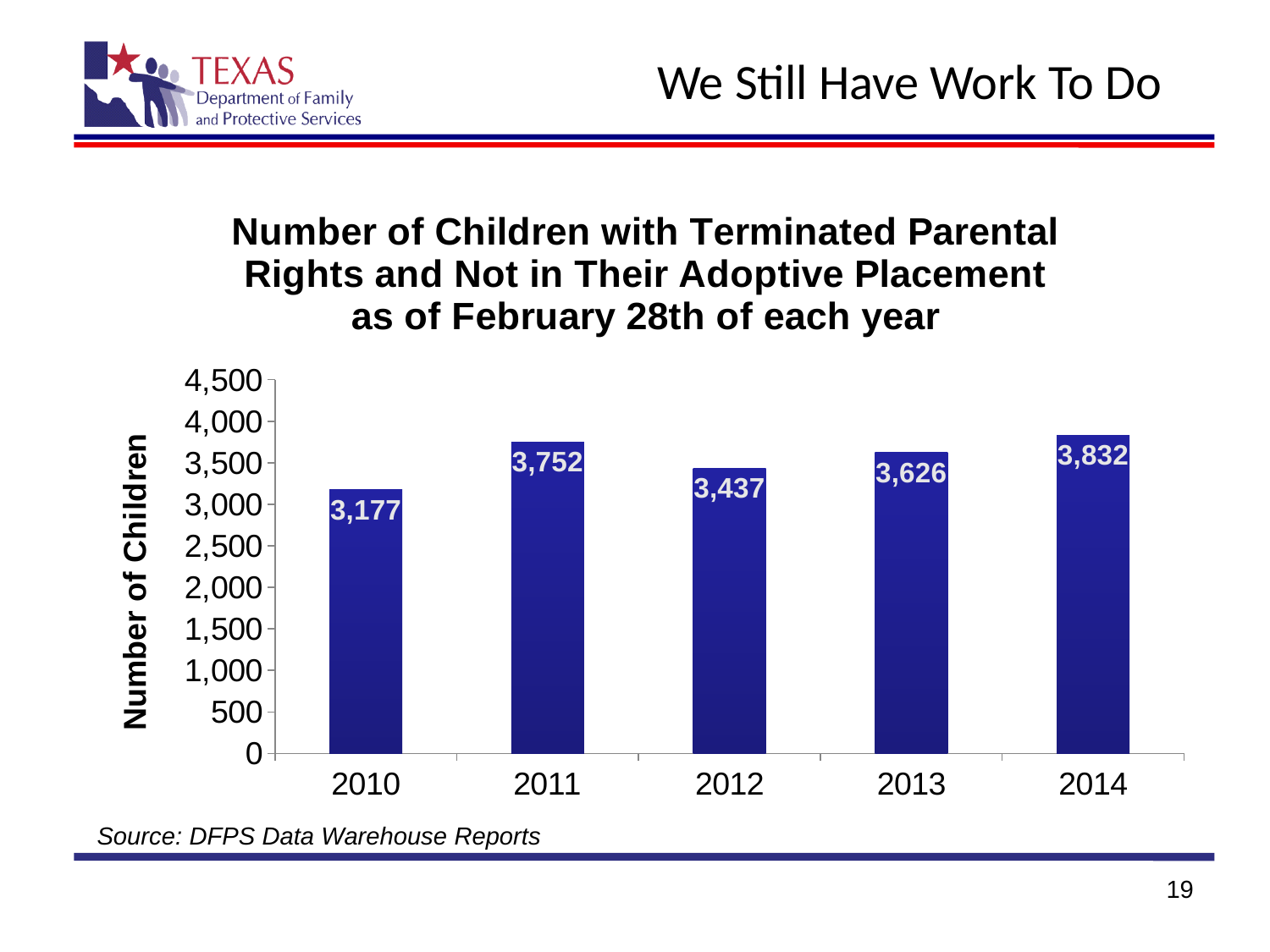
What is the difference between the values for 2014 and 2010? 655 Is the value for 2013 greater or less than 3,500? greater What is the number of children for 2010? 3,177 Which year has the highest number of children? 2014 What kind of chart is shown on the slide? bar chart What is the number of children for 2012? 3,437 What is the label of the y axis? Number of Children What is the difference between the values for 2011 and 2012? 315 What is the number of children for 2014? 3,832 Which is larger, the value for 2011 or the value for 2013? 2011 How many years are shown on the x axis? 5 Which year has the lowest number of children? 2010